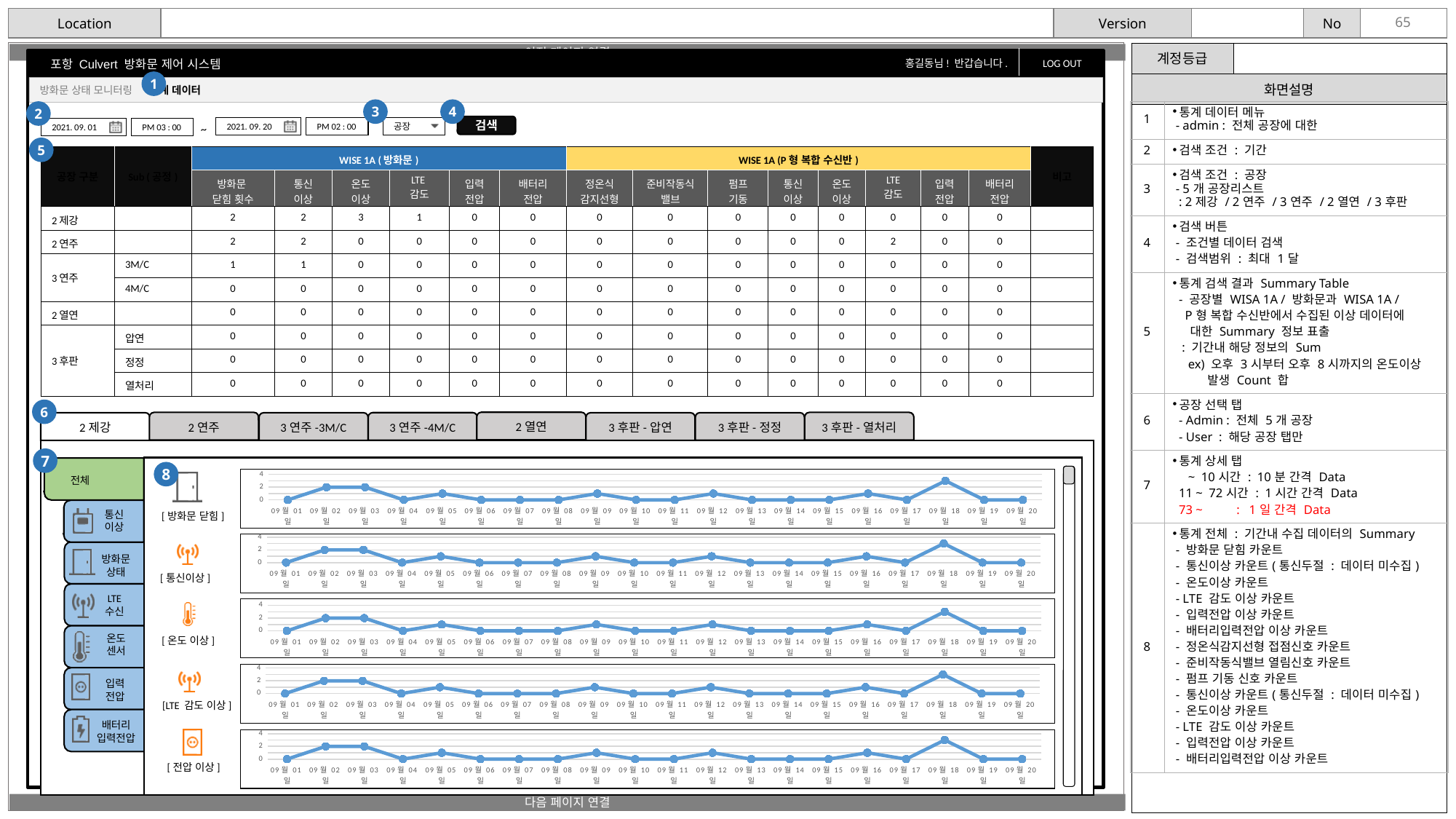
In the [LTE 감도 이상] chart, is the value for 09월 18일 greater or less than 2? greater In the [통신이상] chart, is the value for 09월 01일 greater or less than 2? less In the [온도 이상] chart, is the value for 09월 10일 greater or less than 2? less What is the label shown next to the topmost line chart? [방화문 닫힘] What kind of chart is the [방화문 닫힘] chart? line chart How many line charts are shown in the lower part of the slide? 5 In the [전압 이상] chart, which is larger, the value for 09월 18일 or the value for 09월 01일? 09월 18일 What is the first date shown on the x axis of the [전압 이상] chart? 09월 01일 In the [방화문 닫힘] chart, which date has the highest value? 09월 18일 How many dates are plotted along the x axis of the [방화문 닫힘] chart? 20 In the [온도 이상] chart, which date has the highest value? 09월 18일